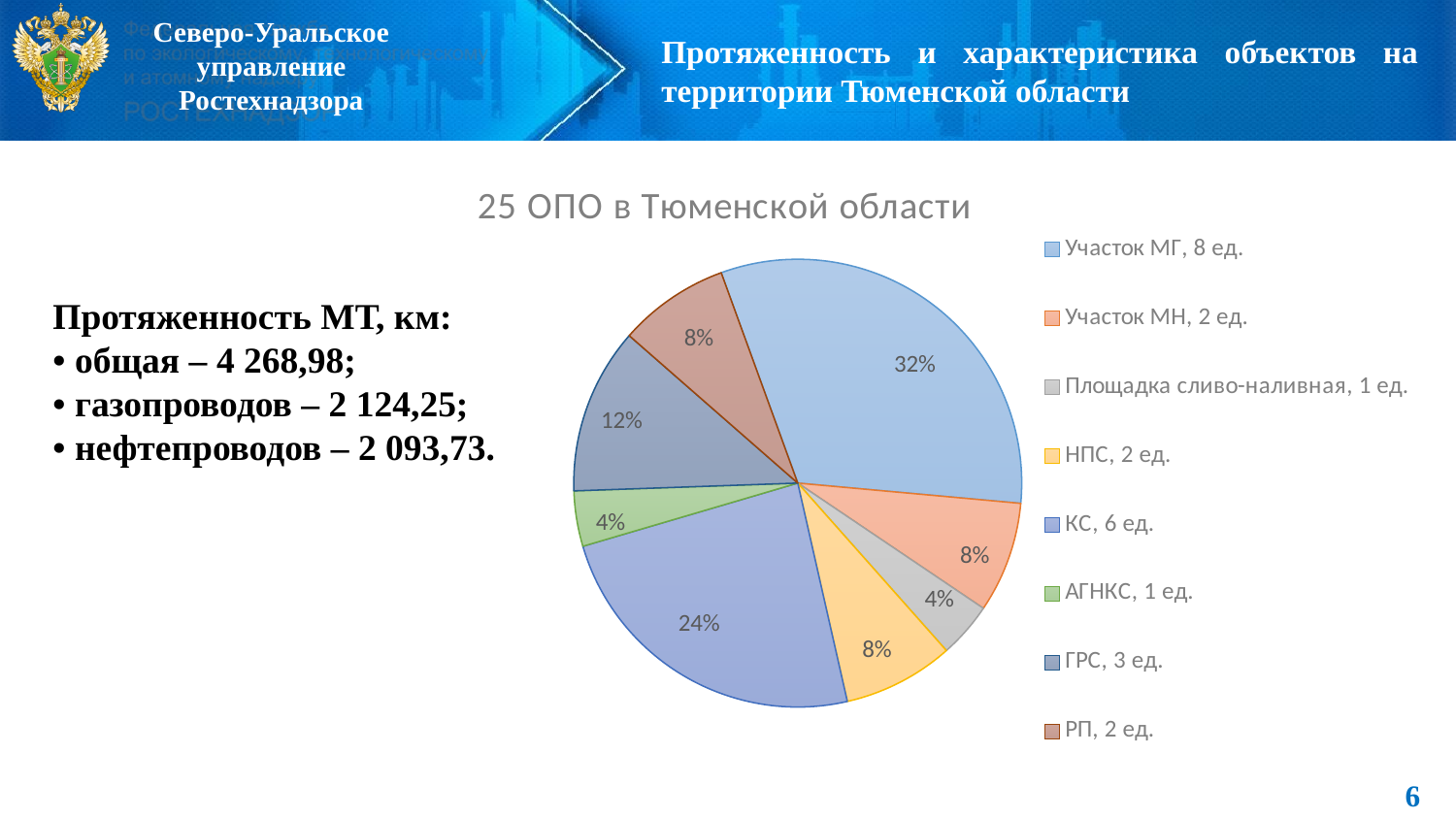
What share of the pie does АГНКС take? 4% What is the title of the chart? 25 ОПО в Тюменской области What kind of chart is shown on the slide? pie chart What share of the pie does ГРС take? 12% Which category has the largest slice of the pie? Участок МГ According to the legend, how many units (ед.) are there for КС? 6 ед. How many categories does the pie chart have? 8 What share of the pie does КС take? 24% Which slice is larger, КС or ГРС? КС What is the difference in percentage points between the Участок МГ slice and the КС slice? 8% According to the legend, how many units (ед.) are there for Участок МГ? 8 ед.